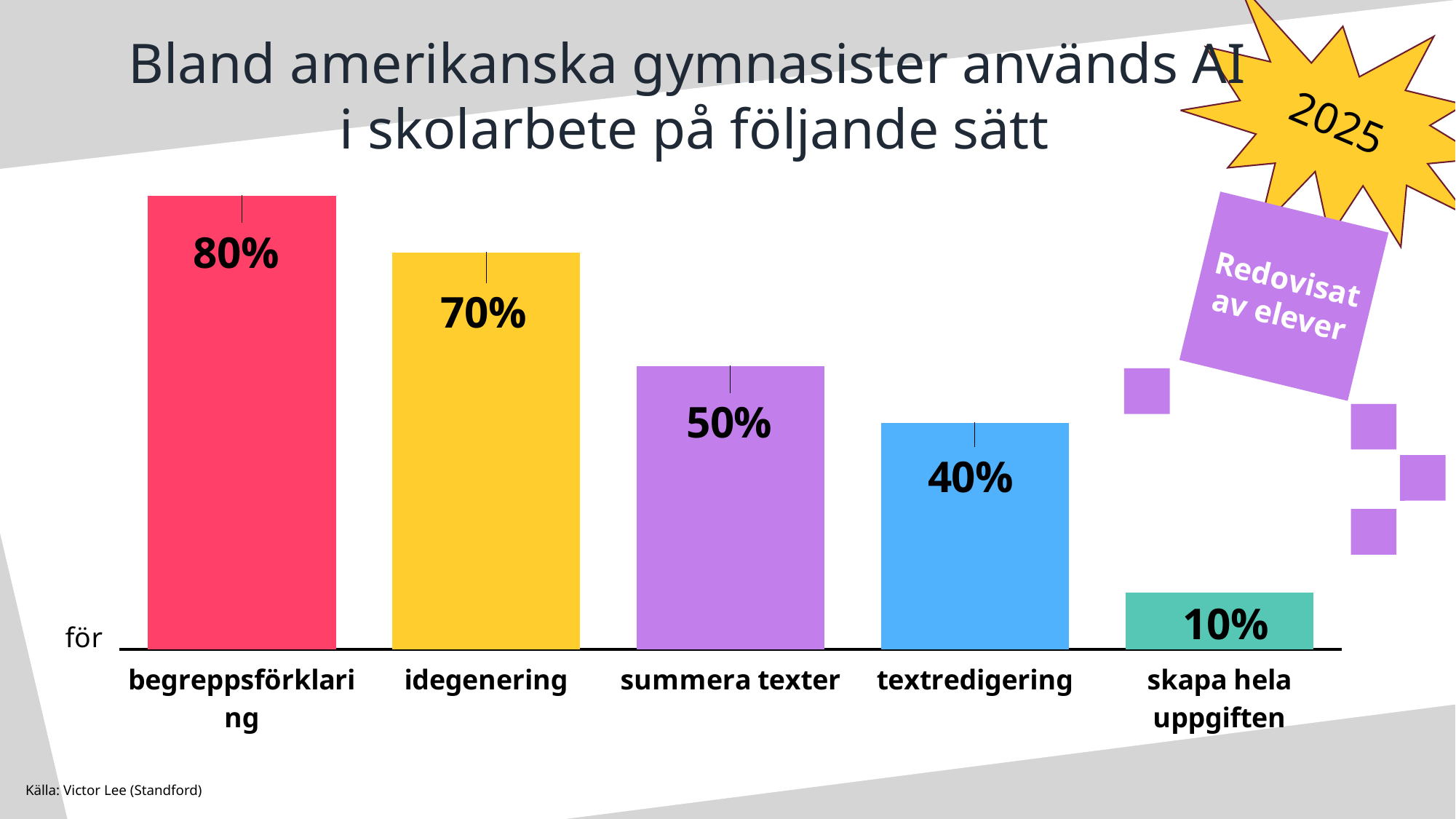
What kind of chart is shown on the slide? bar chart What is the value shown for textredigering? 40% What is the difference between the values for begreppsförklaring and textredigering? 40% Do the values rise or fall from left to right along the x axis? fall Which is larger, the value for idegenering or the value for summera texter? idegenering How many categories are shown in the chart? 5 What is the value shown for summera texter? 50% Which category has the highest value? begreppsförklaring What percentage of American high school students use AI for begreppsförklaring? 80% What is the value shown for skapa hela uppgiften? 10% What is the value shown for idegenering? 70% Which category has the lowest value? skapa hela uppgiften